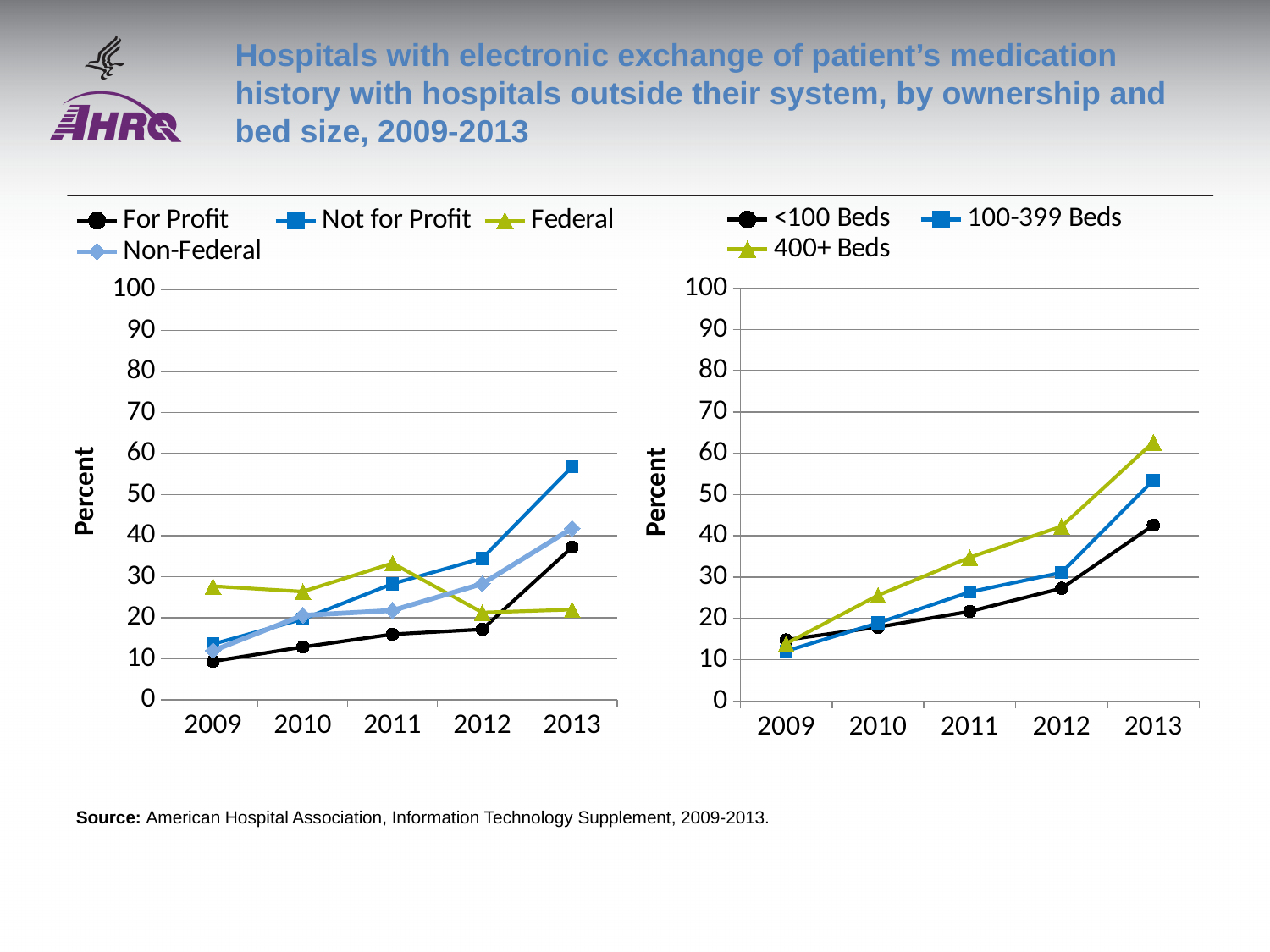
In the left chart (by ownership), is the value for Not for Profit in 2013 greater or less than 50? greater In the right chart (by bed size), which is larger in 2013: 400+ Beds or <100 Beds? 400+ Beds How many years are shown on the x axis of the right chart (by bed size)? 5 How many series does the legend of the left chart (by ownership) list? 4 In the left chart (by ownership), is the value for For Profit in 2009 greater or less than 20? less In the left chart (by ownership), which series has the lowest value in 2013? Federal How many series does the legend of the right chart (by bed size) list? 3 What is the label on the y axis of the right chart (by bed size)? Percent In the right chart (by bed size), does the 400+ Beds series rise or fall from 2009 to 2013? rise In the left chart (by ownership), which series has the highest value in 2013? Not for Profit In the left chart (by ownership), which series has the highest value in 2009? Federal What kind of chart is the left chart (by ownership)? line chart